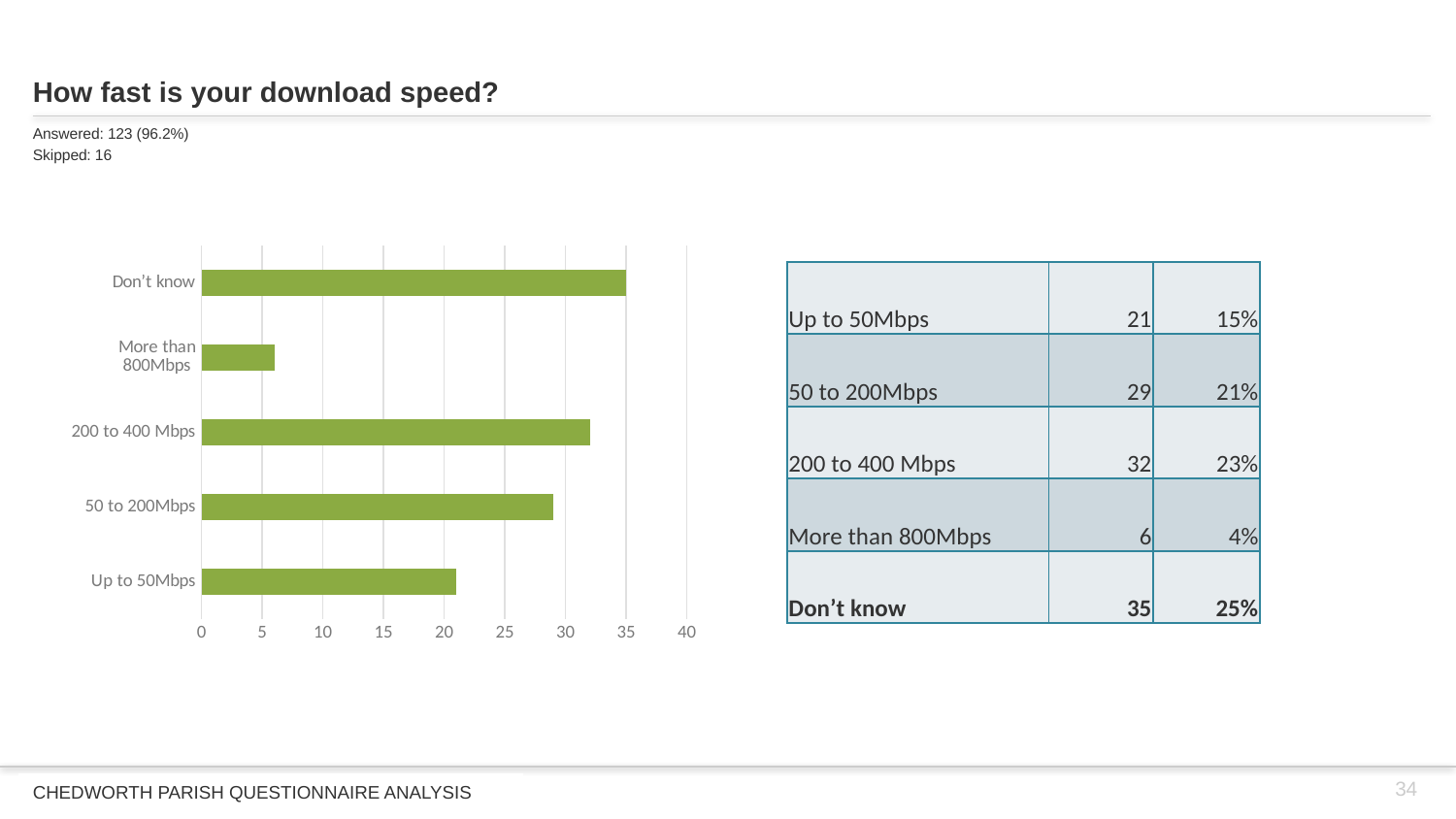
Which is larger, the value for 50 to 200Mbps or the value for Up to 50Mbps? 50 to 200Mbps Which category has the highest value in the chart? Don't know What is the value for Don't know? 35 What is the title of the chart on the slide? How fast is your download speed? What percentage of respondents chose 50 to 200Mbps? 21% What is the value for More than 800Mbps? 6 Which category has the lowest value in the chart? More than 800Mbps What is the value for 200 to 400 Mbps? 32 What is the difference between the value for Don't know and the value for More than 800Mbps? 29 How many categories does the bar chart show? 5 What kind of chart is shown on the slide? bar chart Is the value for Up to 50Mbps greater or less than 25? less